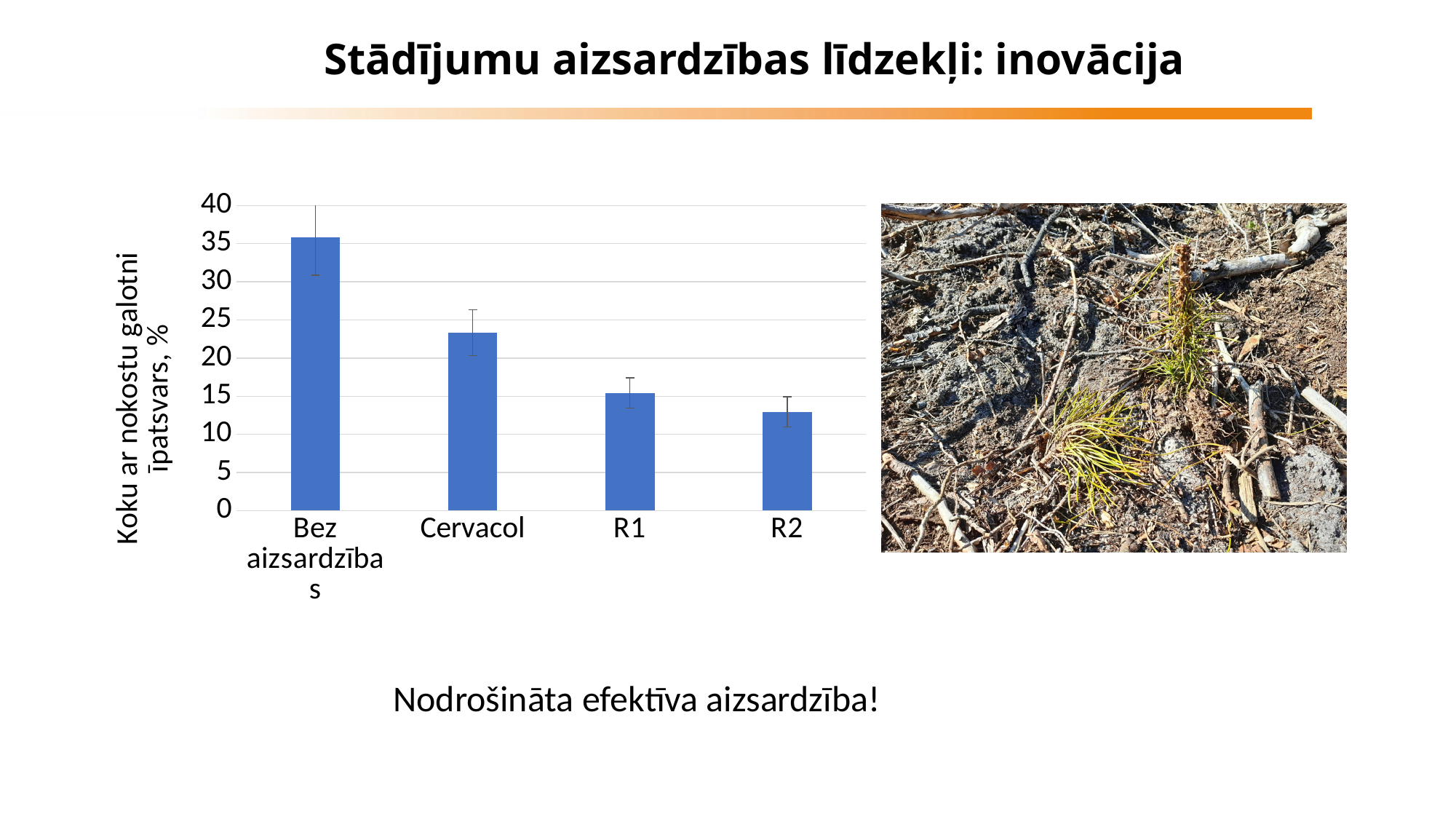
Do the bar values rise or fall from left to right along the x axis? Fall Which category has the lowest bar in the chart? R2 Is the value for Bez aizsardzības greater or less than 30? greater Which category has the highest bar in the chart? Bez aizsardzības Is the value for Cervacol greater or less than 20? greater Is the value for R1 greater or less than 20? less Which has a larger value, R1 or R2? R1 Which has a larger value, Cervacol or R1? Cervacol What is the label of the vertical axis of the chart? Koku ar nokostu galotni īpatsvars, % How many categories are shown on the x axis of the chart? 4 What kind of chart is shown on the slide? Bar chart